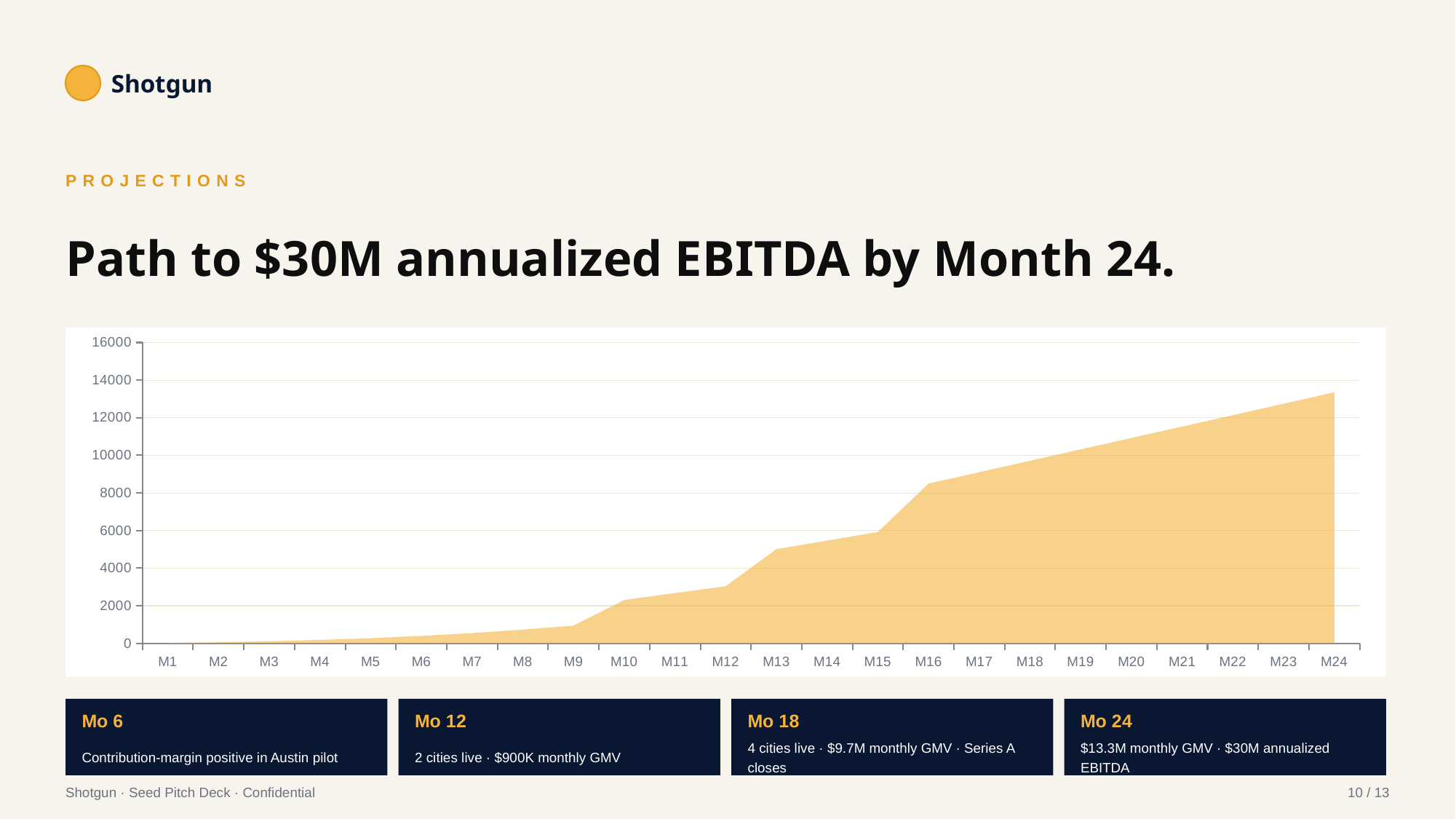
Is the value for M24 greater or less than 12000? greater Which is larger, the value for M16 or the value for M12? M16 Which month has the highest value in the chart? M24 What is the highest value shown on the chart's y axis? 16000 How many months are plotted along the x axis of the chart? 24 Is the value for M20 greater or less than 10000? greater Is the value for M9 greater or less than 2000? less What kind of chart is shown on the slide? area chart Do the values in the chart rise or fall from M1 to M24? rise Which month has the lowest value in the chart? M1